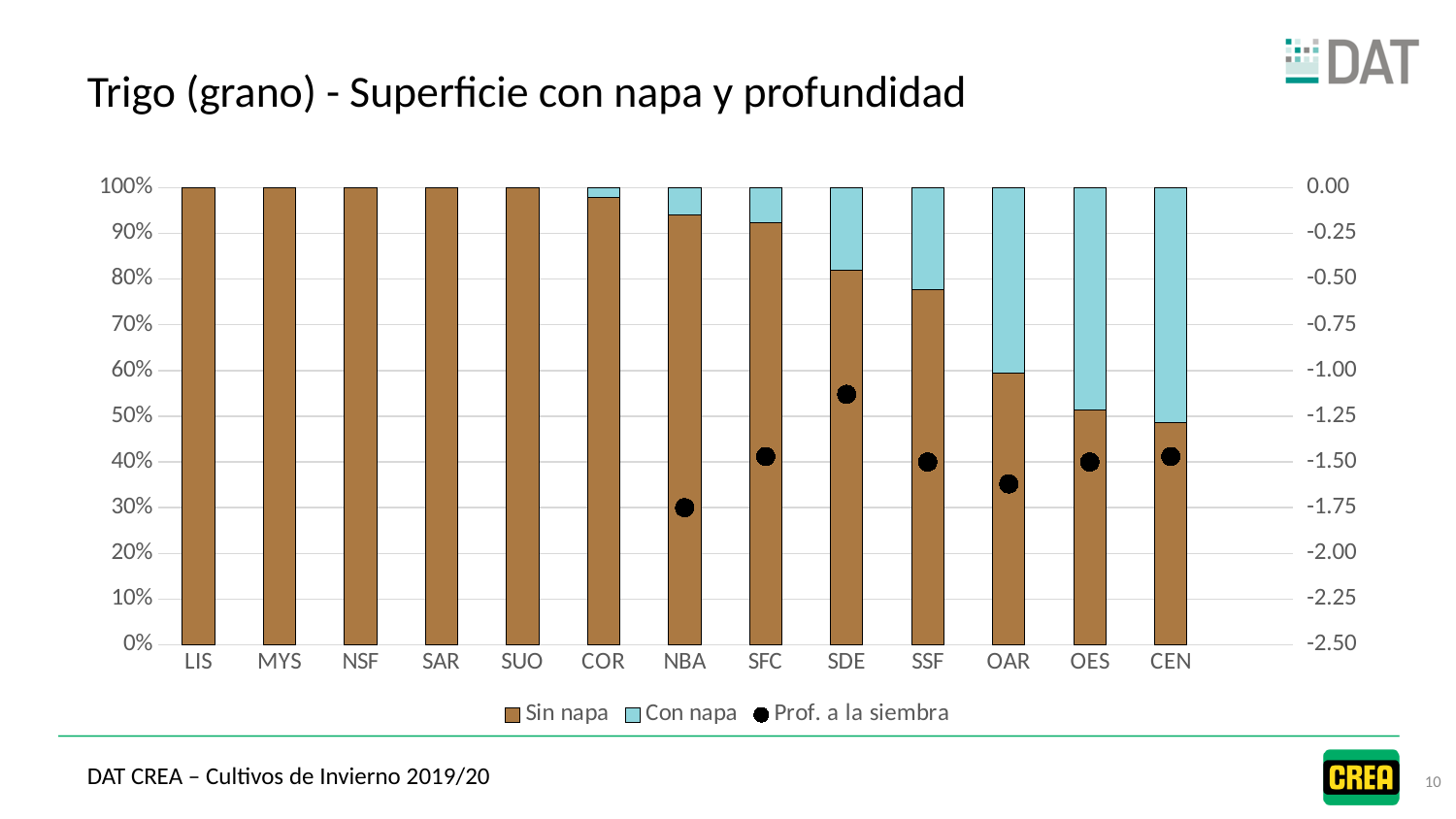
What kind of chart is shown on the slide? Combination chart: stacked bar chart with a point (line) series How many categories are shown on the x axis of the chart? 13 How many series does the chart legend list? 3 What is the total of the stacked bar for SDE? 100% Which has the larger Con napa share, CEN or SDE? CEN Which category has the lowest Prof. a la siembra value (the deepest point)? NBA Which category has the highest Prof. a la siembra value? SDE Is the Sin napa value for SSF greater or less than 80%? less What is the title of the chart on the slide? Trigo (grano) - Superficie con napa y profundidad What is the Sin napa value for LIS? 100% Is the Sin napa value for OAR greater or less than 50%? greater Is the Sin napa value for NBA greater or less than 90%? greater